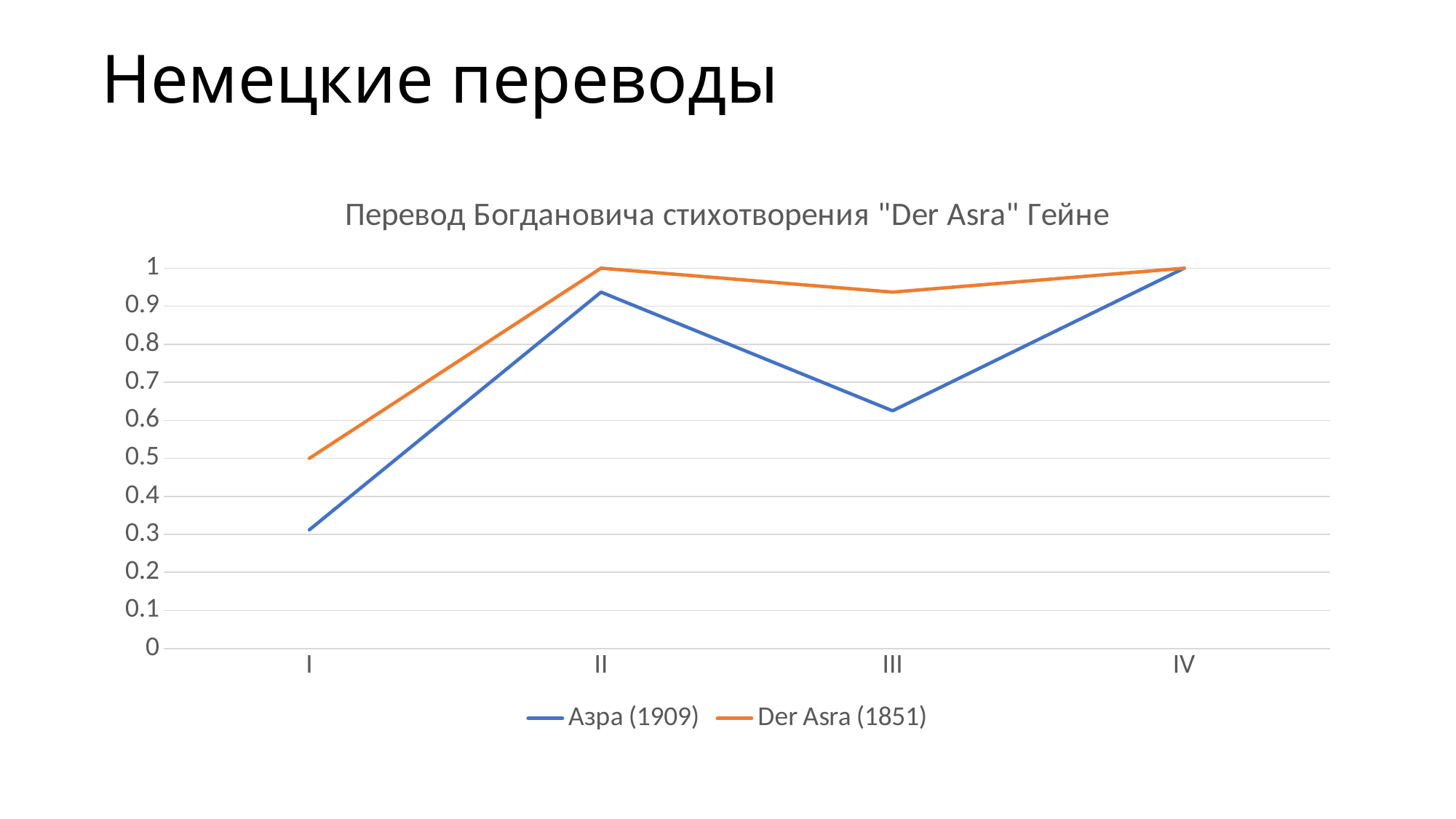
What kind of chart is shown on the slide? line chart What is the value of Der Asra (1851) at category II? 1 Is the value for Азра (1909) at category III greater or less than 0.7? less What is the value of Der Asra (1851) at category I? 0.5 What is the value of Азра (1909) at category IV? 1 How many series does the legend list? 2 At category III, which series has the larger value, Азра (1909) or Der Asra (1851)? Der Asra (1851) Is the value for Азра (1909) at category I greater or less than 0.4? less What is the title of the chart? Перевод Богдановича стихотворения "Der Asra" Гейне How many categories are shown on the x axis? 4 Is the value for Der Asra (1851) at category III greater or less than 0.9? greater At which category is the value of Азра (1909) lowest? I